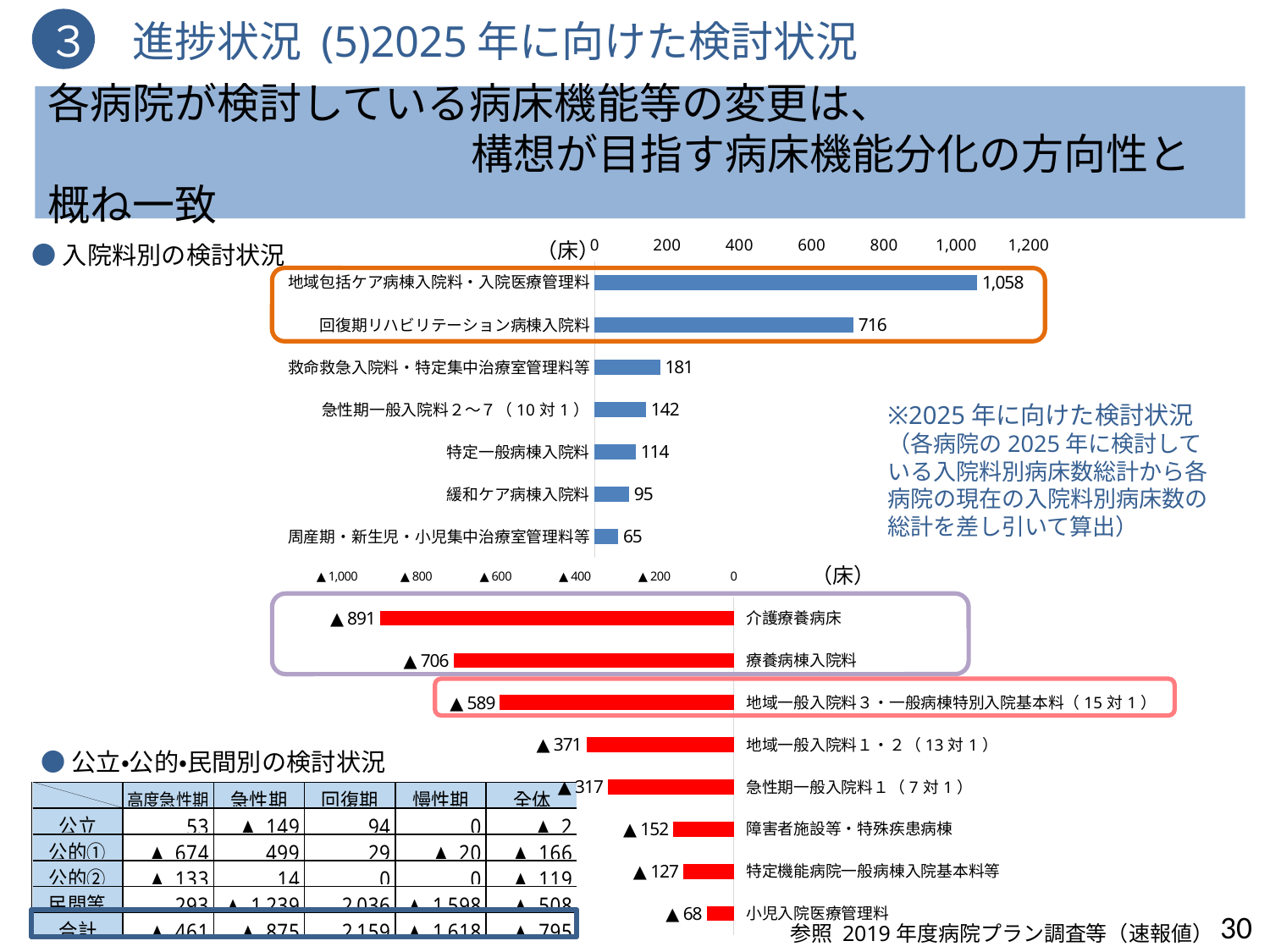
In the lower red bar chart, what is the value shown for 地域一般入院料３・一般病棟特別入院基本料（15対１）? ▲589 In the upper blue bar chart, what is the difference between 回復期リハビリテーション病棟入院料 and 救命救急入院料・特定集中治療室管理料等? 535 In the upper blue bar chart, what is the value for 緩和ケア病棟入院料? 95 What type of chart is the upper blue chart? bar chart In the upper blue bar chart, which category has the lowest value? 周産期・新生児・小児集中治療室管理料等 In the lower red bar chart, which category has the shortest bar? 小児入院医療管理料 In the upper blue bar chart, which category has the highest value? 地域包括ケア病棟入院料・入院医療管理料 In the lower red bar chart, how many categories are plotted? 8 In the upper blue bar chart, what is the value for 地域包括ケア病棟入院料・入院医療管理料? 1,058 In the lower red bar chart, which category has the longest bar? 介護療養病床 In the upper blue bar chart, how many categories are plotted? 7 In the lower red bar chart, what is the value shown for 介護療養病床? ▲891